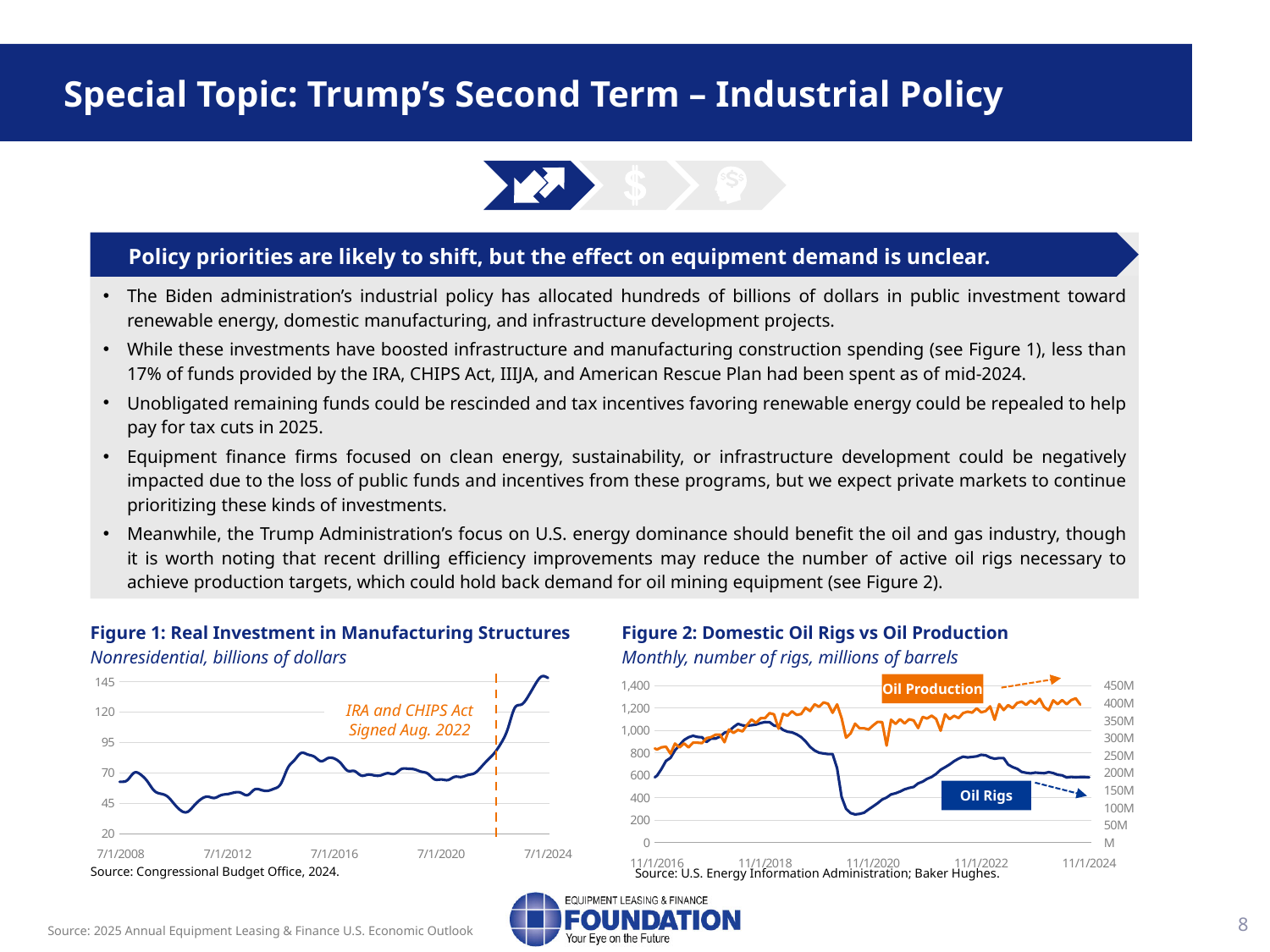
In Figure 1: Real Investment in Manufacturing Structures, is the value at 7/1/2024 greater or less than 120? greater In Figure 2: Domestic Oil Rigs vs Oil Production, what colour is the Oil Production line? orange In Figure 1: Real Investment in Manufacturing Structures, what event does the dashed vertical line mark? IRA and CHIPS Act Signed Aug. 2022 In Figure 2: Domestic Oil Rigs vs Oil Production, is the Oil Rigs value at 11/1/2018 greater or less than 800? greater In Figure 1: Real Investment in Manufacturing Structures, does the line rise or fall between 7/1/2020 and 7/1/2024? rises In Figure 2: Domestic Oil Rigs vs Oil Production, does Oil Production generally rise or fall from 11/1/2016 to 11/1/2024? rises How many series does Figure 2: Domestic Oil Rigs vs Oil Production plot? 2 In Figure 1: Real Investment in Manufacturing Structures, is the value at 7/1/2008 greater or less than 95? less What kind of chart is Figure 2: Domestic Oil Rigs vs Oil Production? line chart What kind of chart is Figure 1: Real Investment in Manufacturing Structures? line chart